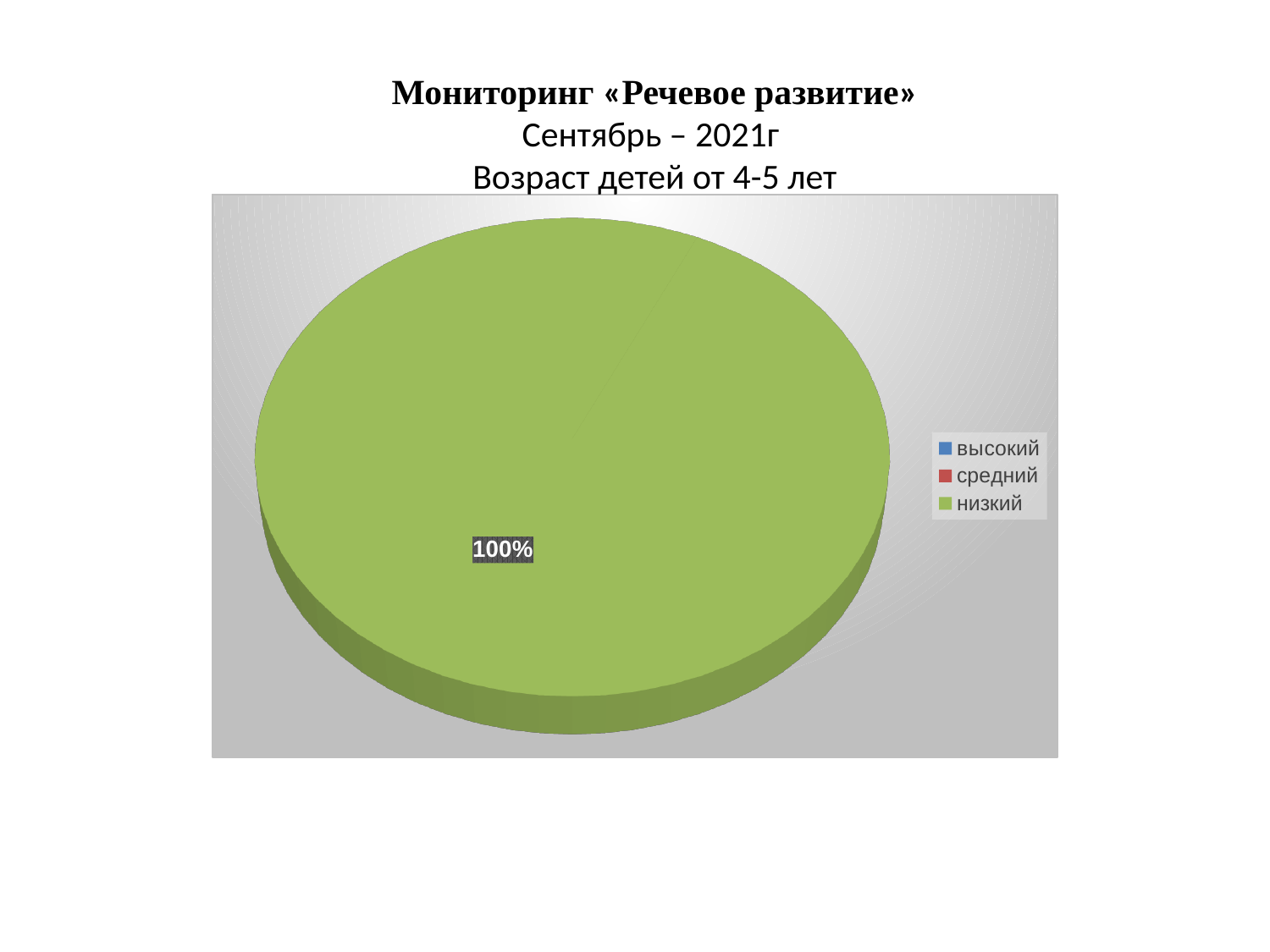
What kind of chart is shown on the slide? pie chart Which category has the largest share of the pie? низкий Which category makes up the entire pie? низкий What month and year are given in the chart title? Сентябрь – 2021г What colour is the "низкий" slice in the pie chart? green How many entries does the legend of the pie chart list? 3 What value is printed on the data label of the pie chart? 100% What share of the pie does the "низкий" category take? 100%